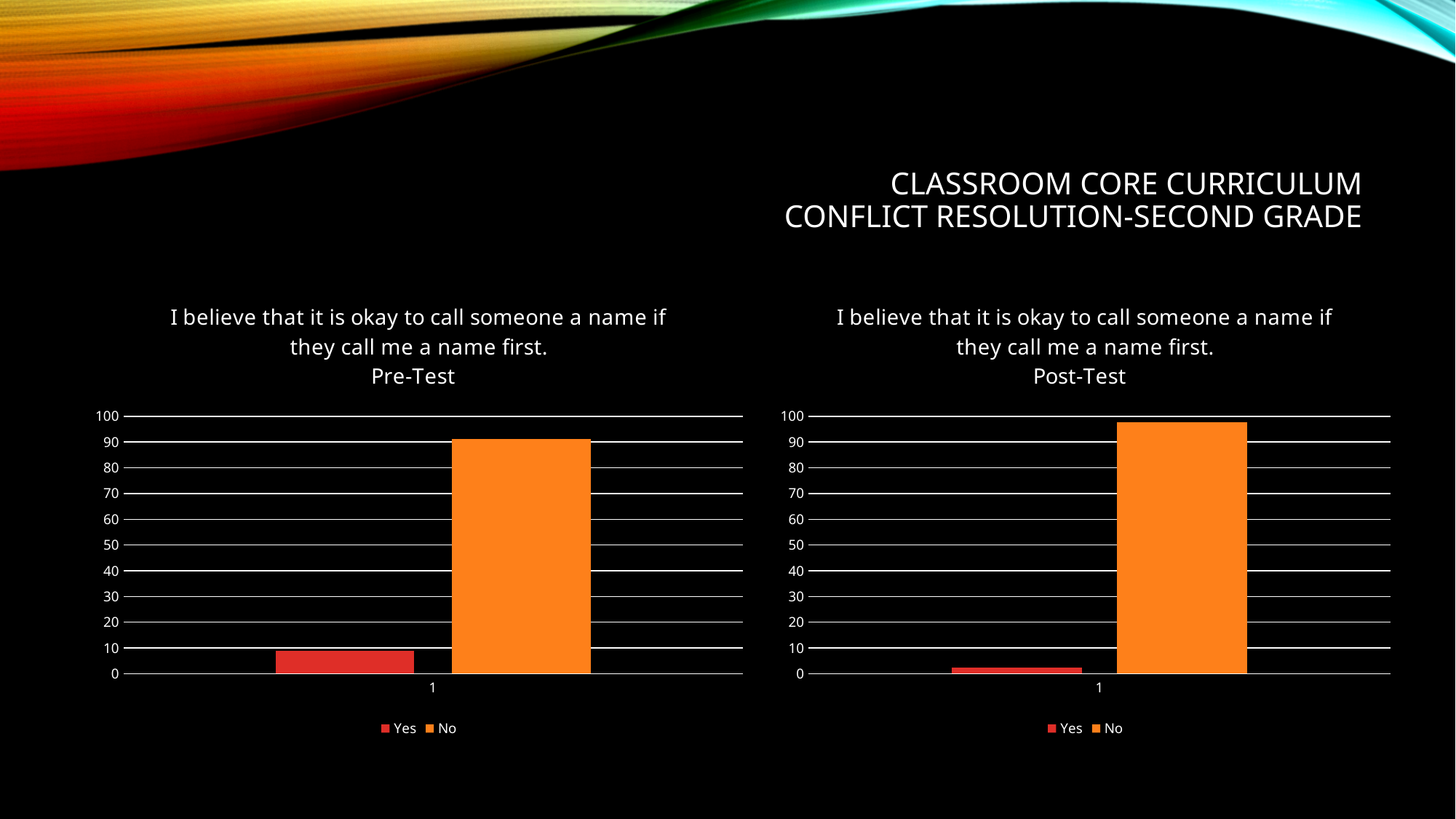
In the Post-Test chart, which series has the lowest bar? Yes What colour is the No series in the Post-Test chart? orange In the Post-Test chart, which series has the highest bar? No In the Post-Test chart, is the value for Yes greater or less than 10? less What kind of chart is the Pre-Test chart? bar chart In the Pre-Test chart, is the value for No greater or less than 80? greater How many bars are plotted in the Pre-Test chart? 2 In the Pre-Test chart, is the value for Yes greater or less than 20? less In the Pre-Test chart, which series has the higher bar, Yes or No? No What is the highest value shown on the vertical axis of the Pre-Test chart? 100 How many series does the legend of the Post-Test chart list? 2